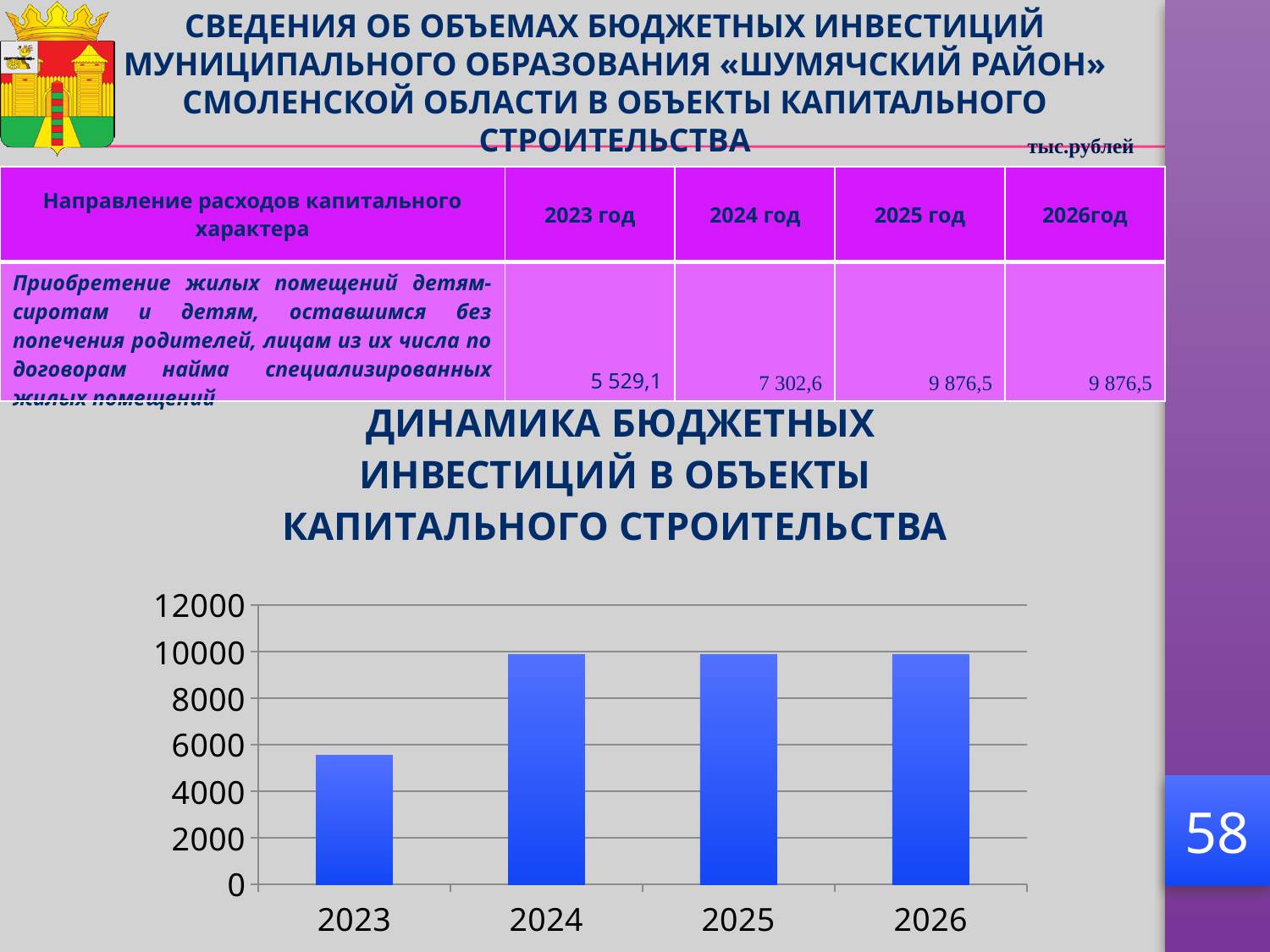
Which year has the lowest bar in the chart? 2023 How many years are shown on the x axis of the chart? 4 Is the value for 2025 greater or less than 8000? greater What is the highest tick value shown on the vertical axis of the chart? 12000 Is the value for 2024 greater or less than 8000? greater Is the value for 2023 greater or less than 4000? greater What colour are the bars in the chart? blue Which is larger, the value for 2023 or the value for 2024? 2024 What kind of chart is shown on the slide? bar chart Do the values rise or fall from 2023 to 2024? rise